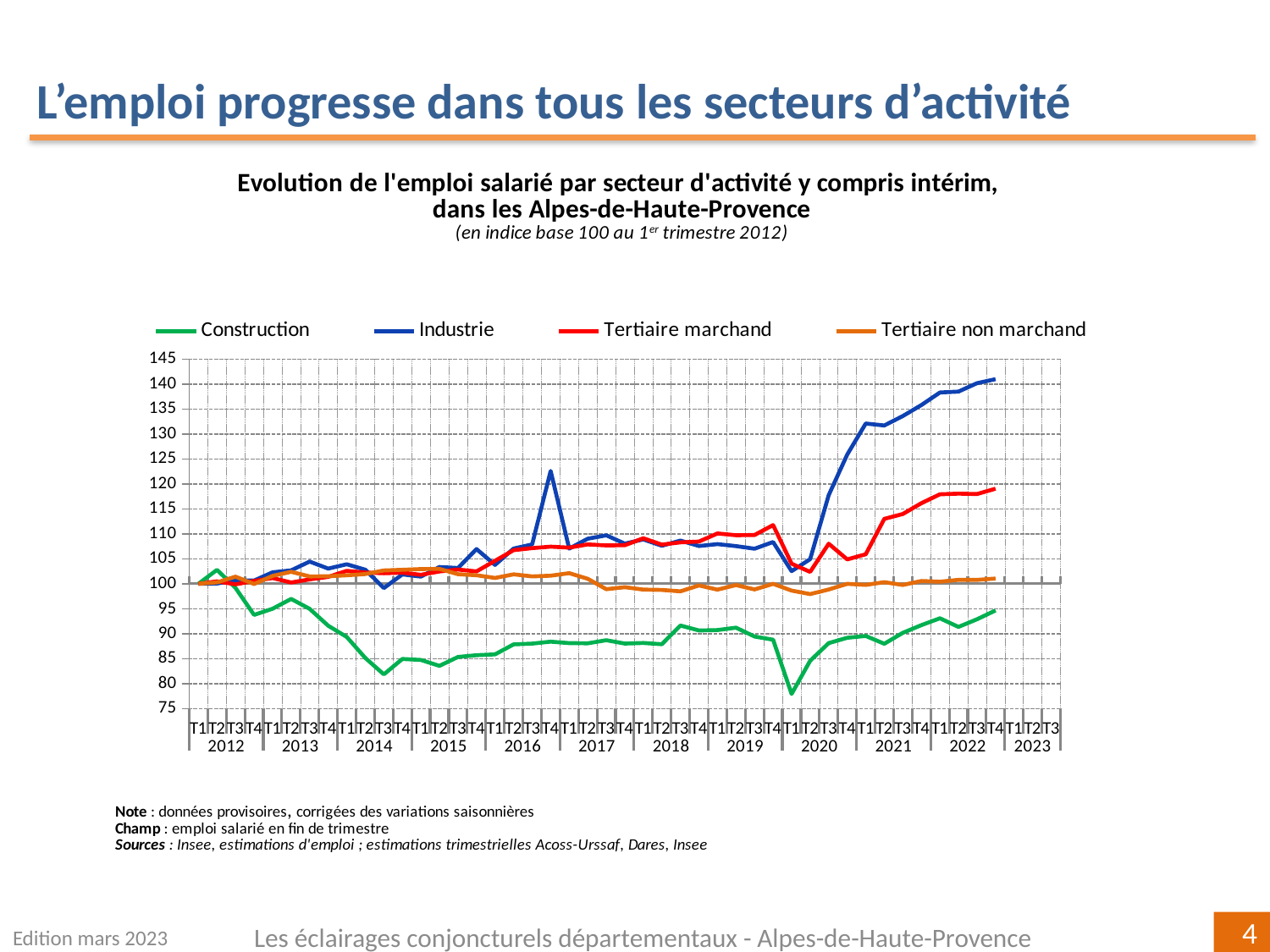
What kind of chart is shown on the slide? line chart Which series is plotted in green? Construction Is the value for Construction at T1 2020 greater or less than 80? less What is the base value of the index, according to the chart subtitle? 100 au 1er trimestre 2012 Does the Construction series rise or fall between T1 2012 and T3 2014? fall How many series does the legend list? 4